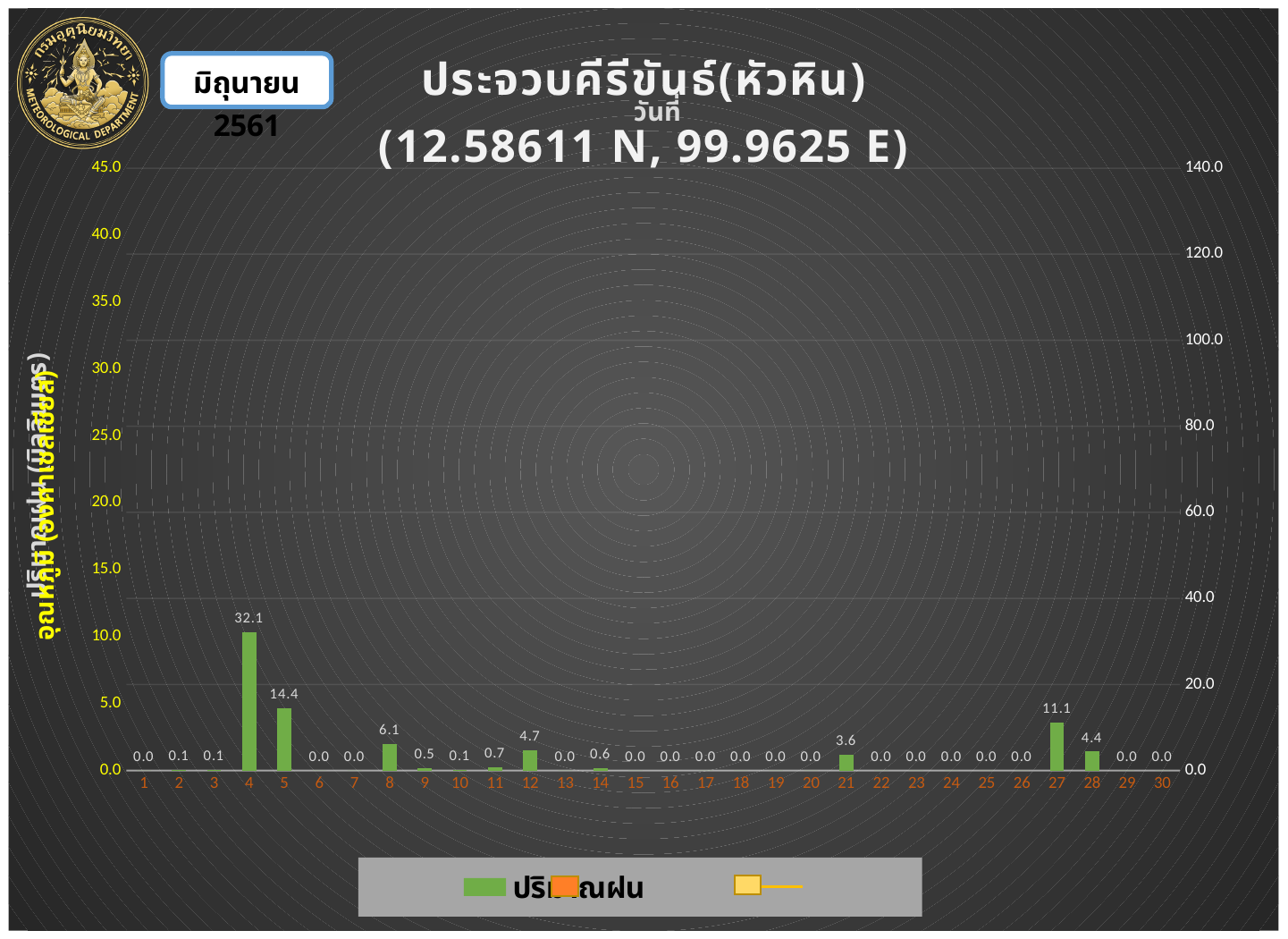
What month and year are shown in the box at the top left of the slide? มิถุนายน 2561 What is the rainfall value shown for day 21? 3.6 What is the difference between the rainfall values for day 4 and day 5? 17.7 How many days are shown on the x axis? 30 What is the difference between the rainfall values for day 27 and day 28? 6.7 Which is larger, the rainfall value for day 5 or for day 27? day 5 What is the rainfall value shown for day 27? 11.1 Which day has the highest rainfall value? 4 What is the rainfall value shown for day 12? 4.7 What kind of chart is shown on the slide? bar chart What is the rainfall value shown for day 4? 32.1 Which is larger, the rainfall value for day 8 or for day 12? day 8